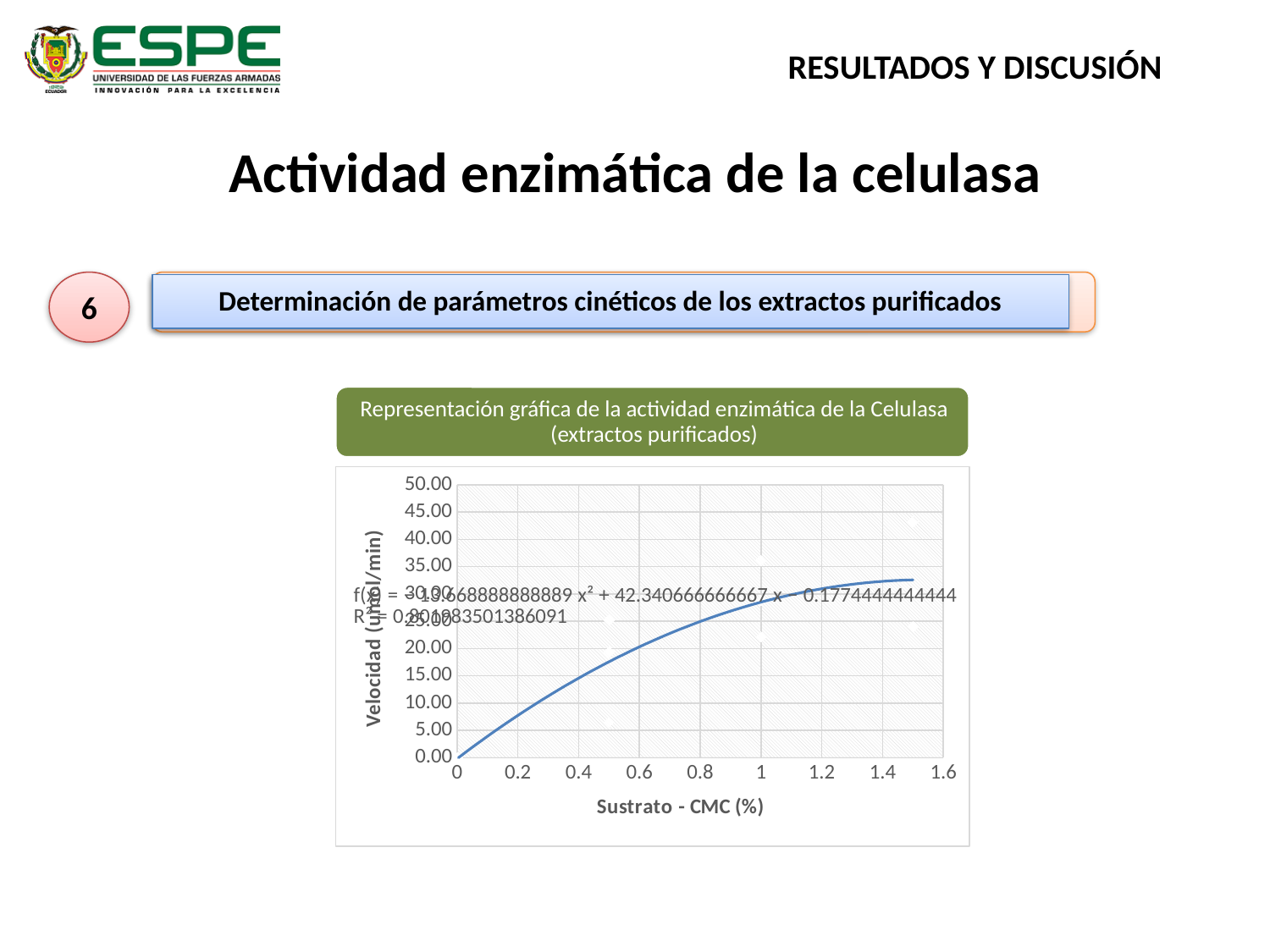
Is the value of the fitted curve at a substrate concentration of 0.2 greater or less than 10.00? less Does the fitted curve rise or fall as the substrate concentration increases along the x axis? rise What is the title of the x axis of the chart? Sustrato - CMC (%) Is the value of the fitted curve at a substrate concentration of 1.4 greater or less than 40.00? less Is the value of the fitted curve at a substrate concentration of 0.4 greater or less than 10.00? greater What kind of chart is shown on the slide? scatter chart What is the title shown above the chart? Representación gráfica de la actividad enzimática de la Celulasa (extractos purificados)